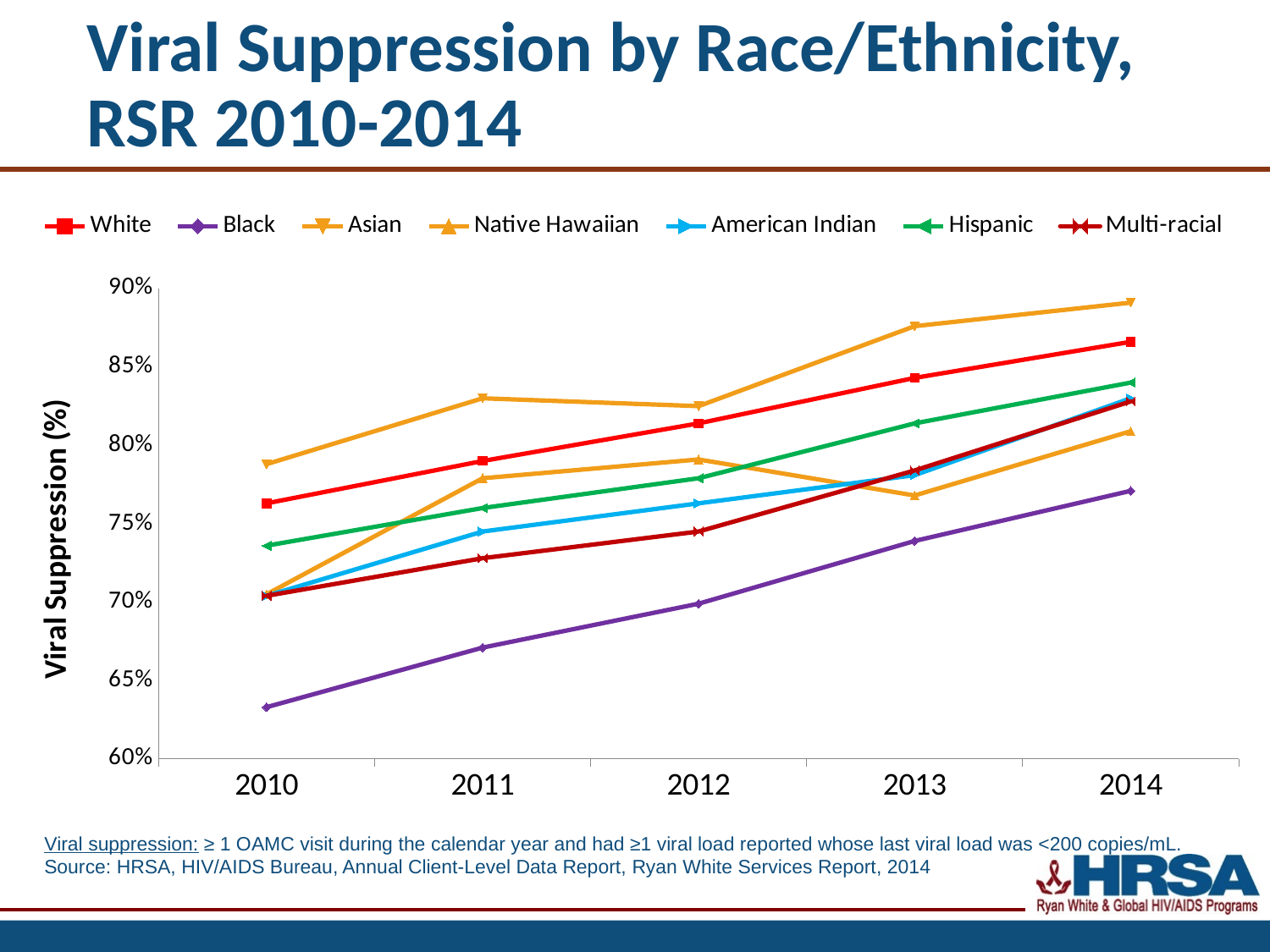
What colour is the line for White in the chart? red How many series does the legend list? 7 Which race/ethnicity group has the lowest viral suppression in 2010? Black Which race/ethnicity group has the highest viral suppression in 2014? Asian Is the viral suppression value for Asian in 2014 greater or less than 85%? greater What is the label on the y axis? Viral Suppression (%) Does the viral suppression for Black rise or fall from 2010 to 2014? rise Is the viral suppression value for Black in 2010 greater or less than 65%? less In 2012, which is larger: the viral suppression for White or for Hispanic? White Which race/ethnicity group has the lowest viral suppression in 2014? Black What type of chart is shown on the slide? line chart How many years are shown along the x axis? 5